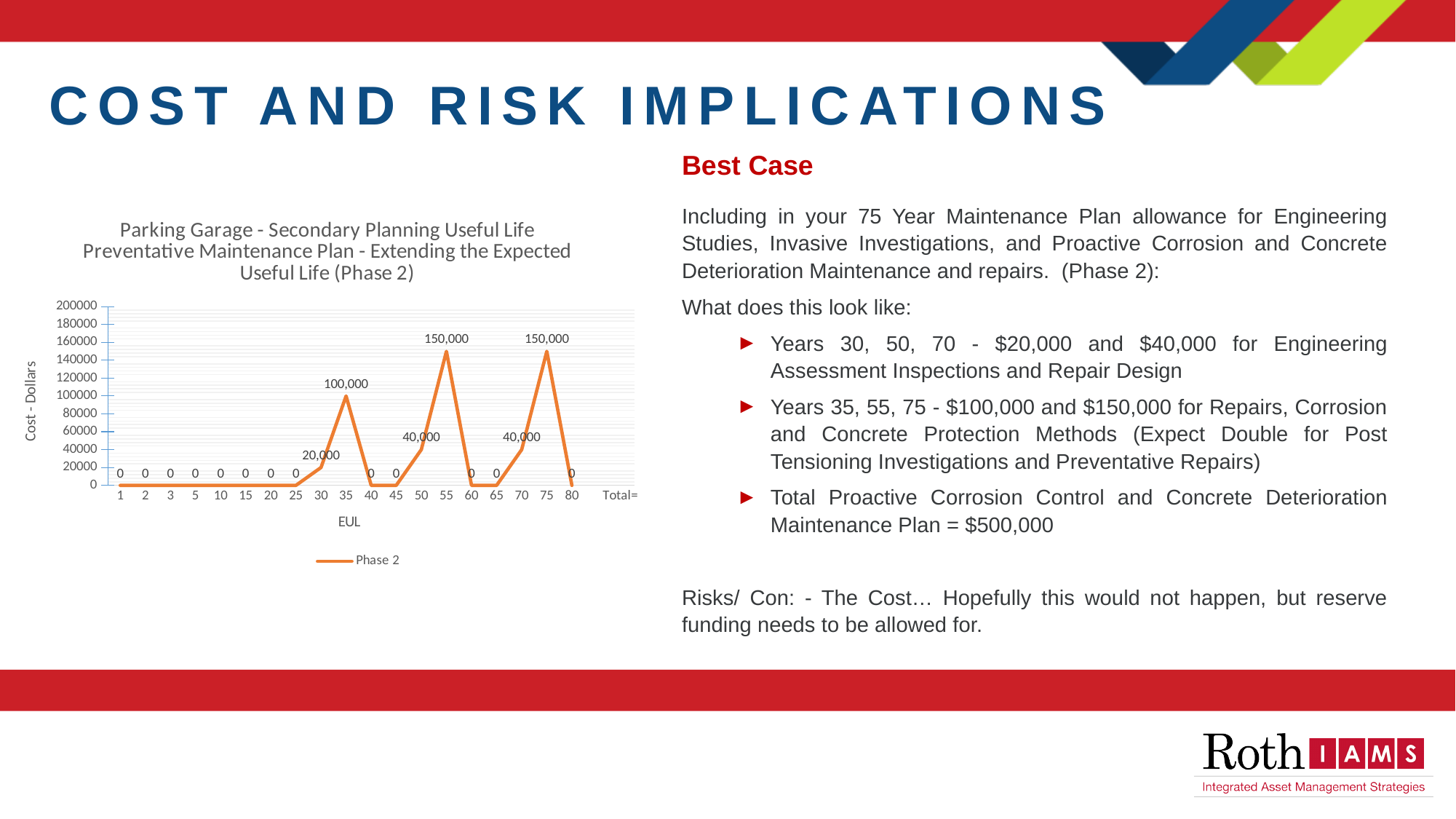
What kind of chart is shown on the slide? Line chart How many series does the legend list? 1 What is the difference between the values for EUL 55 and EUL 50? 110,000 What is the title of the y axis of the chart? Cost - Dollars What is the value for EUL 35 in the Parking Garage Phase 2 chart? 100,000 What is the value for EUL 55 in the chart? 150,000 What is the value for EUL 30 in the chart? 20,000 What is the difference between the values for EUL 35 and EUL 30? 80,000 What is the value for EUL 40 in the chart? 0 Which has the larger value, EUL 35 or EUL 70? EUL 35 What is the value for EUL 70 in the chart? 40,000 What is the highest value plotted in the chart? 150,000